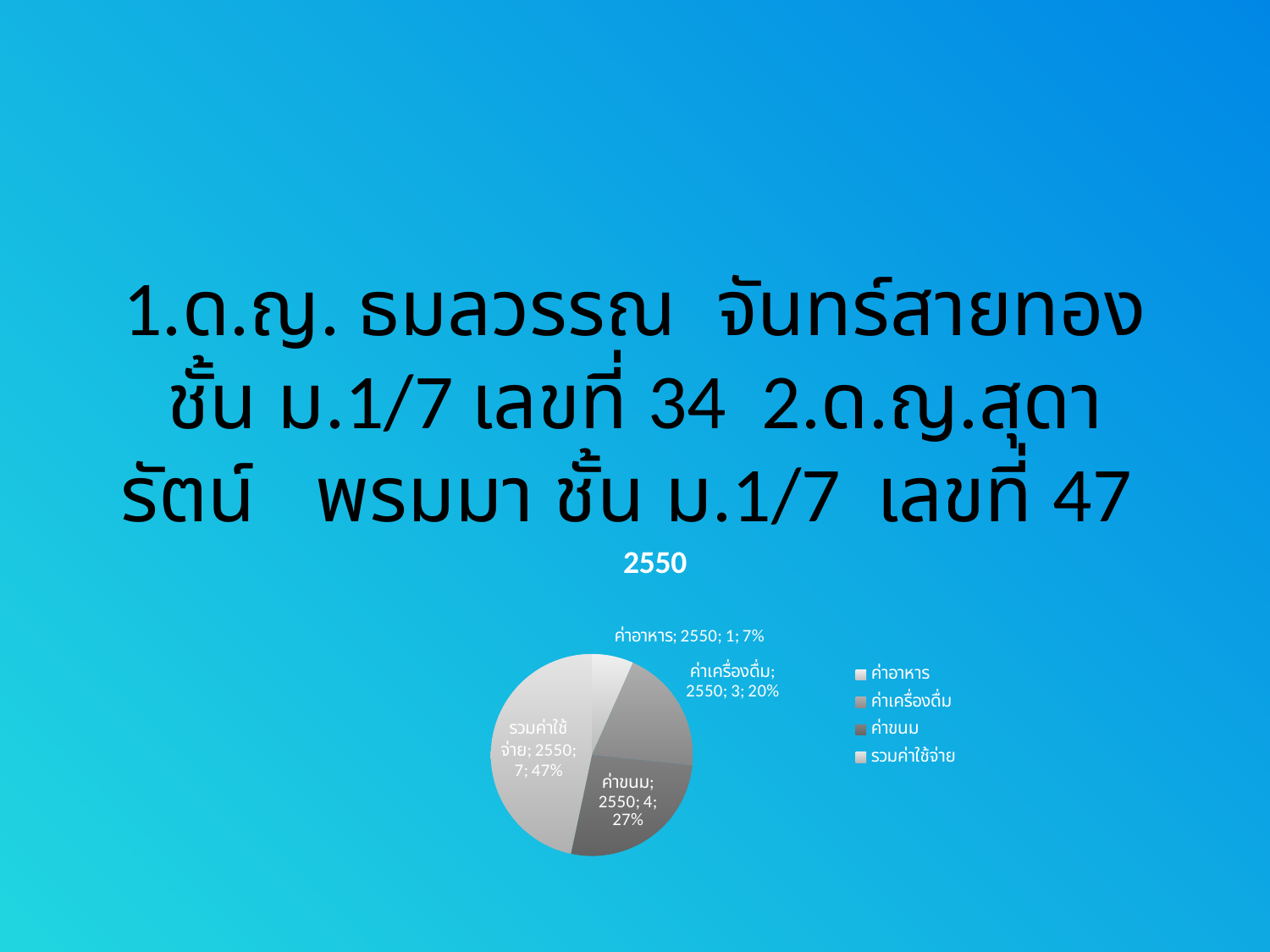
What is the title of the chart? 2550 What is the value for ค่าขนม? 4 What is the value for รวมค่าใช้จ่าย? 7 Which category has the largest slice of the pie? รวมค่าใช้จ่าย What share of the pie does ค่าขนม represent? 27% How many entries does the legend list? 4 What kind of chart is shown on the slide? pie chart What is the difference between the values for ค่าขนม and ค่าเครื่องดื่ม? 1 Which category has the smallest slice of the pie? ค่าอาหาร What is the value for ค่าเครื่องดื่ม? 3 How many slices does the pie chart have? 4 What is the value for ค่าอาหาร? 1